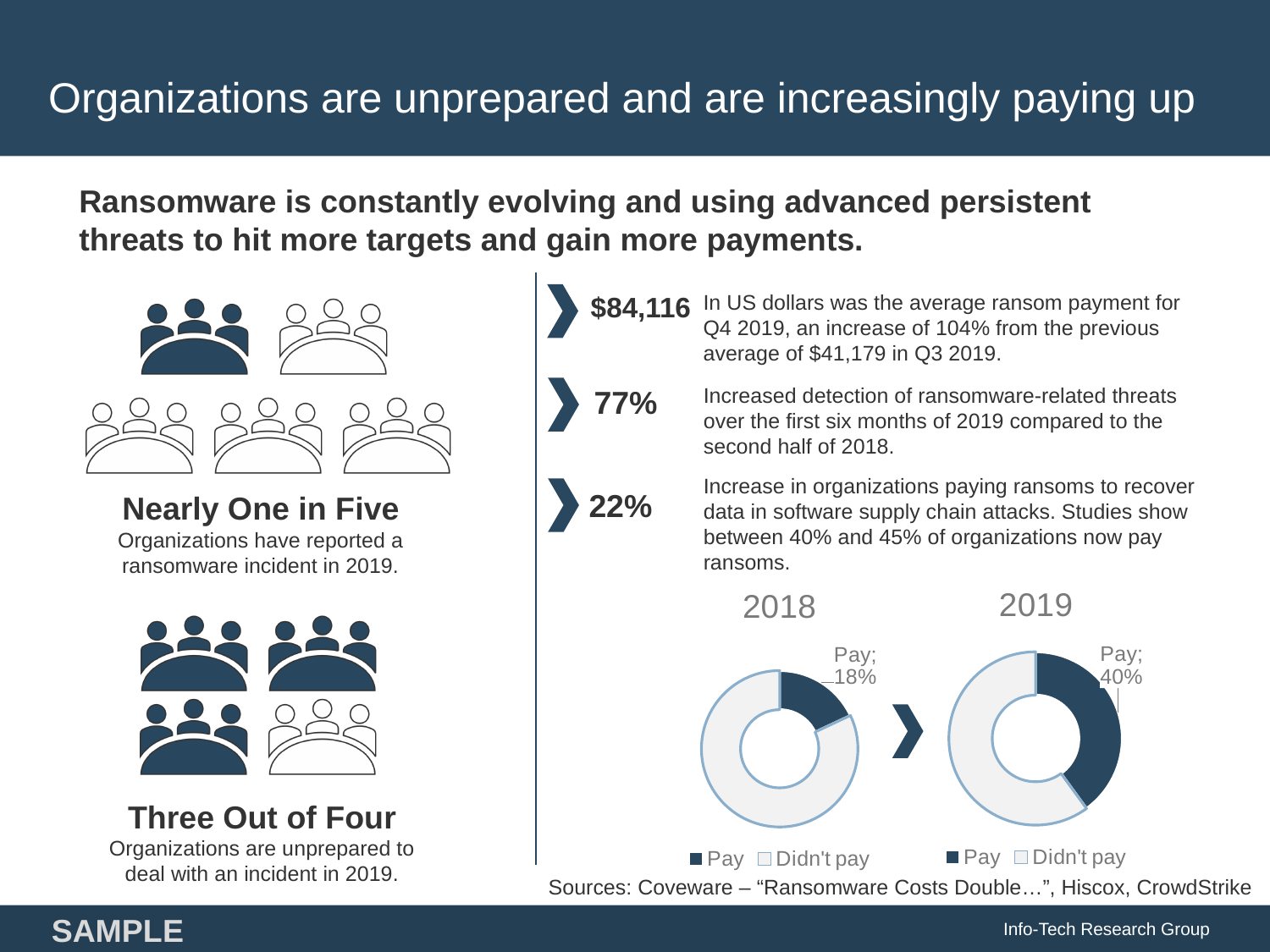
Did the Pay share rise or fall from the 2018 chart to the 2019 chart? Rise In the 2018 donut chart, what percentage of organizations paid the ransom? 18% How many entries does the legend of the 2019 chart list? 2 How many slices does the 2018 donut chart have? 2 What colour is the Pay slice in the donut charts? Dark blue In the 2019 chart, which slice is larger, Pay or Didn't pay? Didn't pay What kind of chart is used to show the 2018 and 2019 Pay versus Didn't pay data? Pie chart (donut) In the 2018 chart, which slice is larger, Pay or Didn't pay? Didn't pay Which chart shows a larger Pay share, 2018 or 2019? 2019 In the 2019 donut chart, what percentage of organizations paid the ransom? 40% What is the title of the left donut chart? 2018 By how many percentage points did the Pay share increase from the 2018 chart to the 2019 chart? 22 percentage points